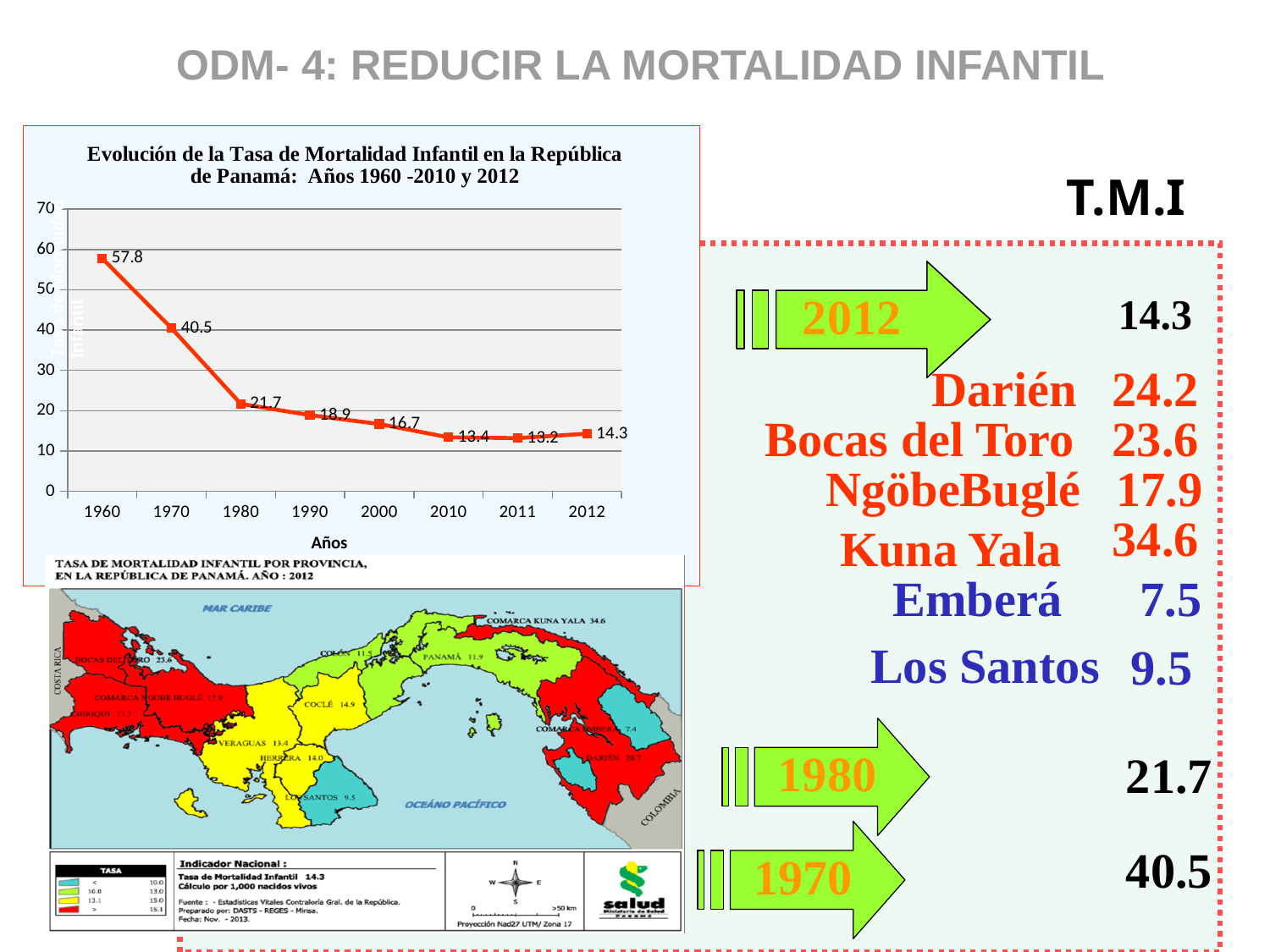
Which year has the highest value in the line chart? 1960 How many data points are plotted in the line chart? 8 What is the value plotted for 2012 in the line chart? 14.3 Which is larger in the line chart, the value for 2010 or the value for 2012? 2012 What type of chart is used to show the evolution of the infant mortality rate in Panama? line chart What is the x-axis label of the line chart? Años What is the difference between the values for 1960 and 1970 in the line chart? 17.3 What is the value plotted for 2000 in the line chart? 16.7 Does the value in the line chart generally rise or fall from 1960 to 2011? fall Which year has the lowest value in the line chart? 2011 What is the infant mortality rate value plotted for 1960? 57.8 What is the value plotted for 1980 in the line chart? 21.7